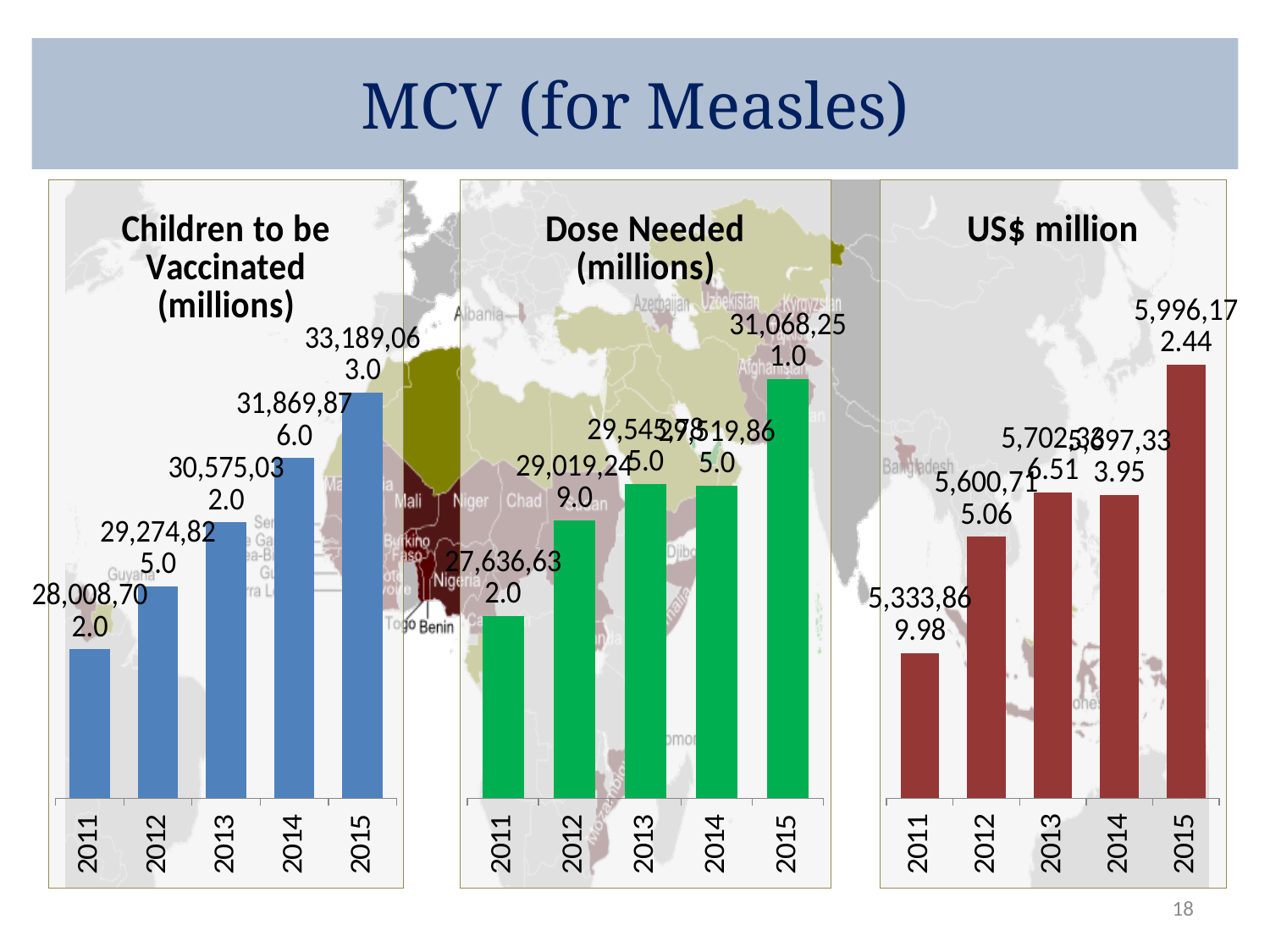
How many years are shown on the x axis of the "Dose Needed (millions)" chart? 5 In the "US$ million" chart, is the bar for 2012 taller or shorter than the bar for 2015? shorter In the "US$ million" chart, which year has the lowest bar? 2011 In the "Dose Needed (millions)" chart, which year has the lowest bar? 2011 In the "Children to be Vaccinated (millions)" chart, do the values rise or fall from 2011 to 2015? rise In the "US$ million" chart, which year has the highest bar? 2015 What is the data label shown for 2011 in the "Children to be Vaccinated (millions)" chart? 28,008,702.0 What colour are the bars in the "Dose Needed (millions)" chart? green In the "Dose Needed (millions)" chart, which year has the highest bar? 2015 In the "Children to be Vaccinated (millions)" chart, which year has the highest bar? 2015 In the "Children to be Vaccinated (millions)" chart, which year has the lowest bar? 2011 What kind of chart is the "Children to be Vaccinated (millions)" chart? bar chart